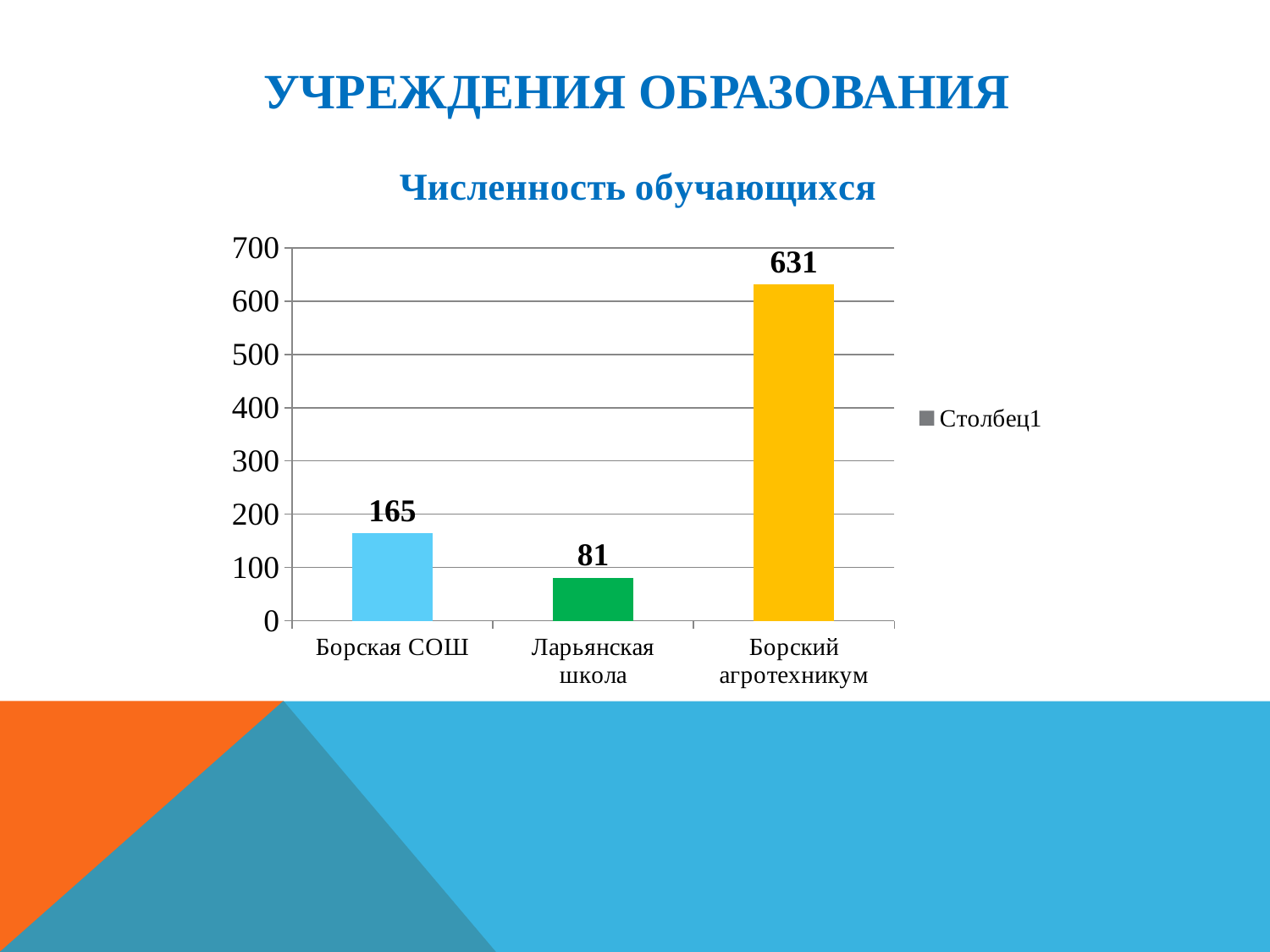
Is the value for Борский агротехникум greater or less than 600? greater What is the value for Борская СОШ? 165 Which is larger, the value for Борская СОШ or the value for Ларьянская школа? Борская СОШ Which category has the lowest value? Ларьянская школа What is the title of the chart? Численность обучающихся How many categories are shown on the x axis? 3 What is the value for Борский агротехникум? 631 What is the difference between the values for Борский агротехникум and Борская СОШ? 466 What is the difference between the values for Борская СОШ and Ларьянская школа? 84 What is the value for Ларьянская школа? 81 Which category has the highest value? Борский агротехникум What kind of chart is shown on the slide? bar chart